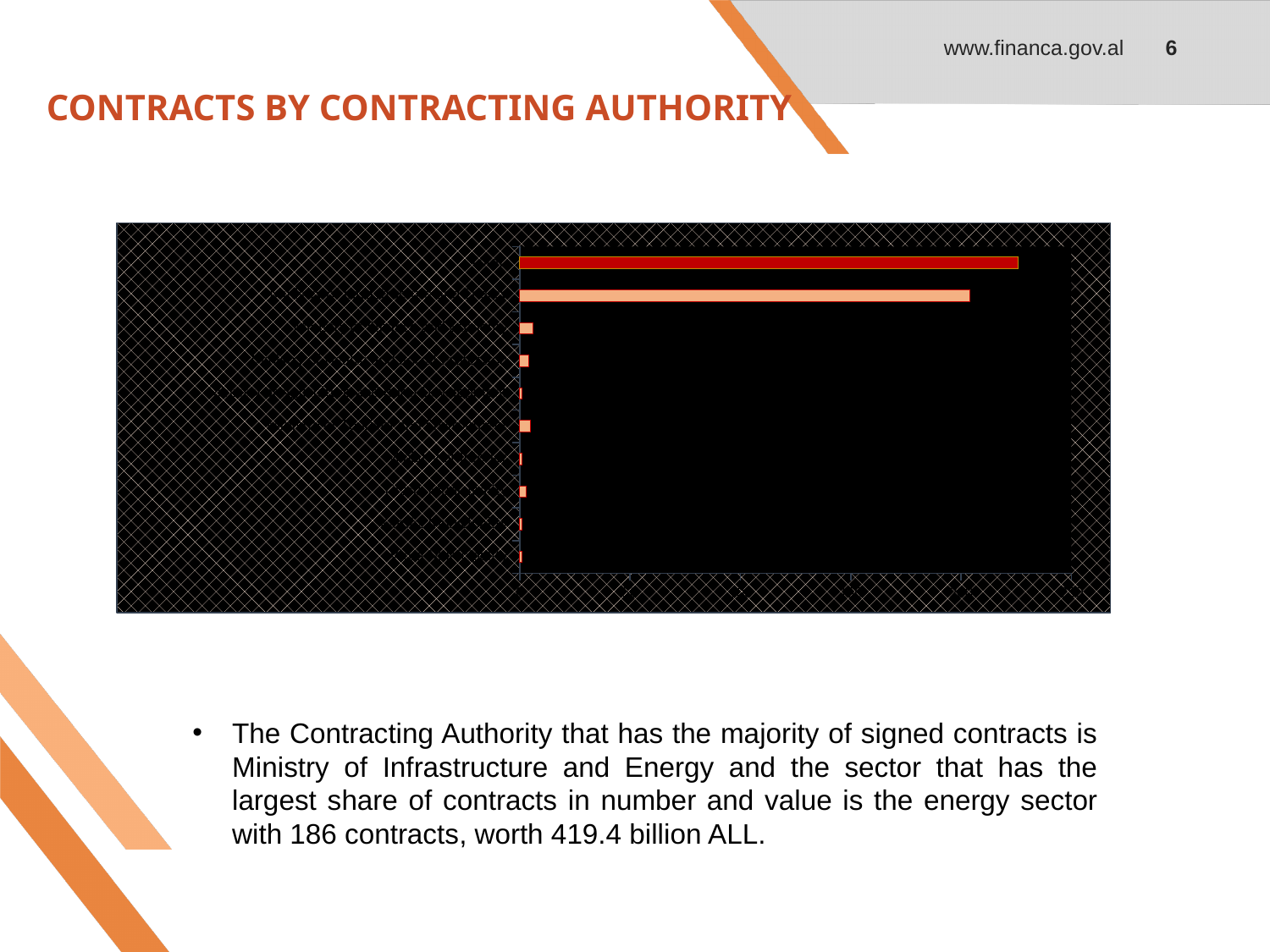
How many bars are plotted in the chart? 10 What colour is the longest (top) bar in the chart? dark red Is the first bar from the top longer or shorter than the second bar from the top? longer Which bar in the chart is the longest, by its position from the top? the first (top) bar Are the bars in the chart drawn horizontally or vertically? horizontally What kind of chart is shown on the slide? bar chart